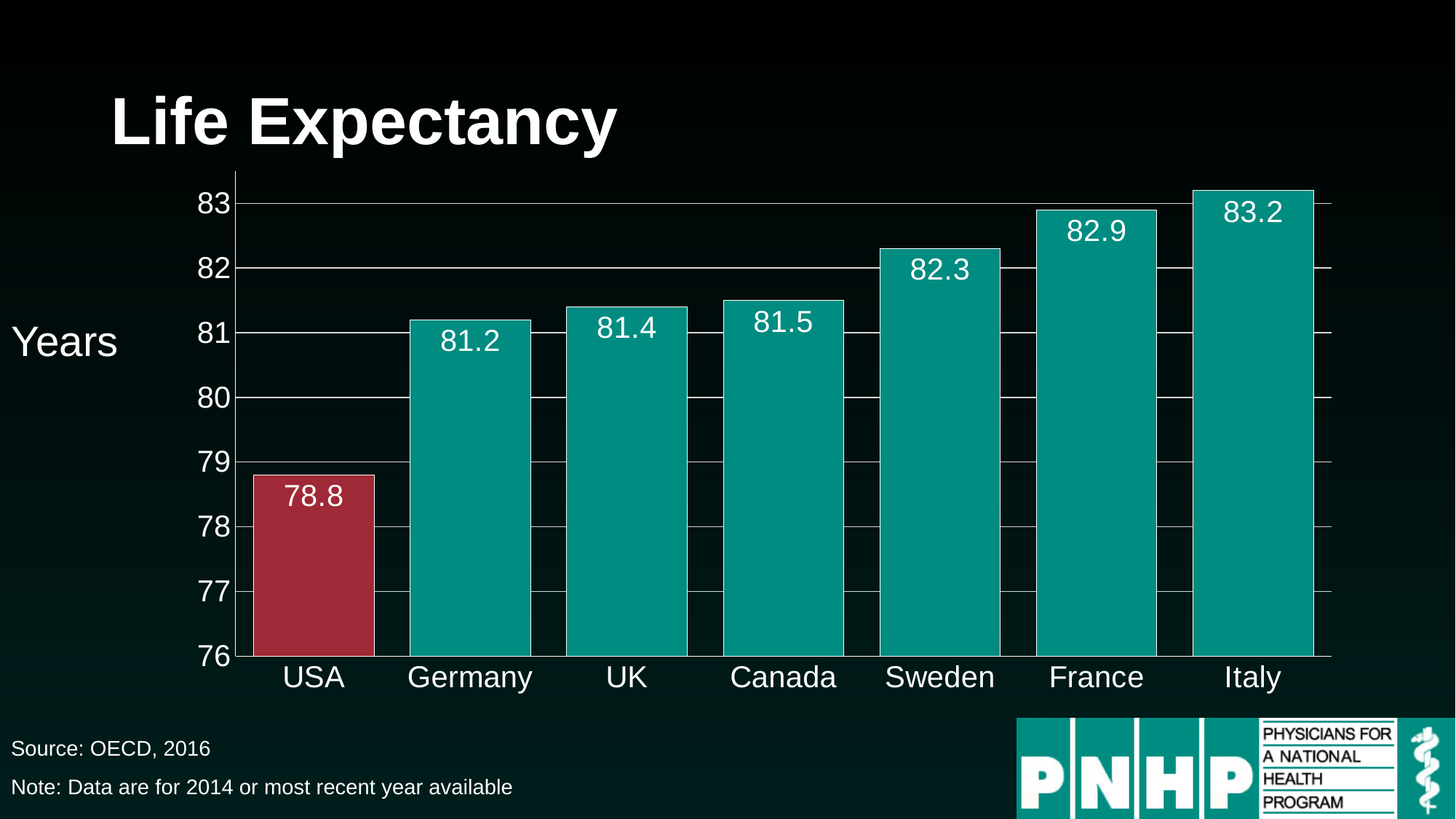
What is the life expectancy value shown for the USA? 78.8 Do the life expectancy values rise or fall from left to right across the chart? Rise What is the life expectancy value shown for Canada? 81.5 Which country's bar is shown in a different colour (red) from the others? USA What kind of chart is shown on the slide? Bar chart Which has a higher life expectancy, the UK or Sweden? Sweden What is the difference in life expectancy between Italy and the USA? 4.4 Which country has the lowest life expectancy on the chart? USA Which country has the highest life expectancy on the chart? Italy How many countries are shown on the chart? 7 What is the difference in life expectancy between France and Germany? 1.7 What is the life expectancy value shown for Sweden? 82.3